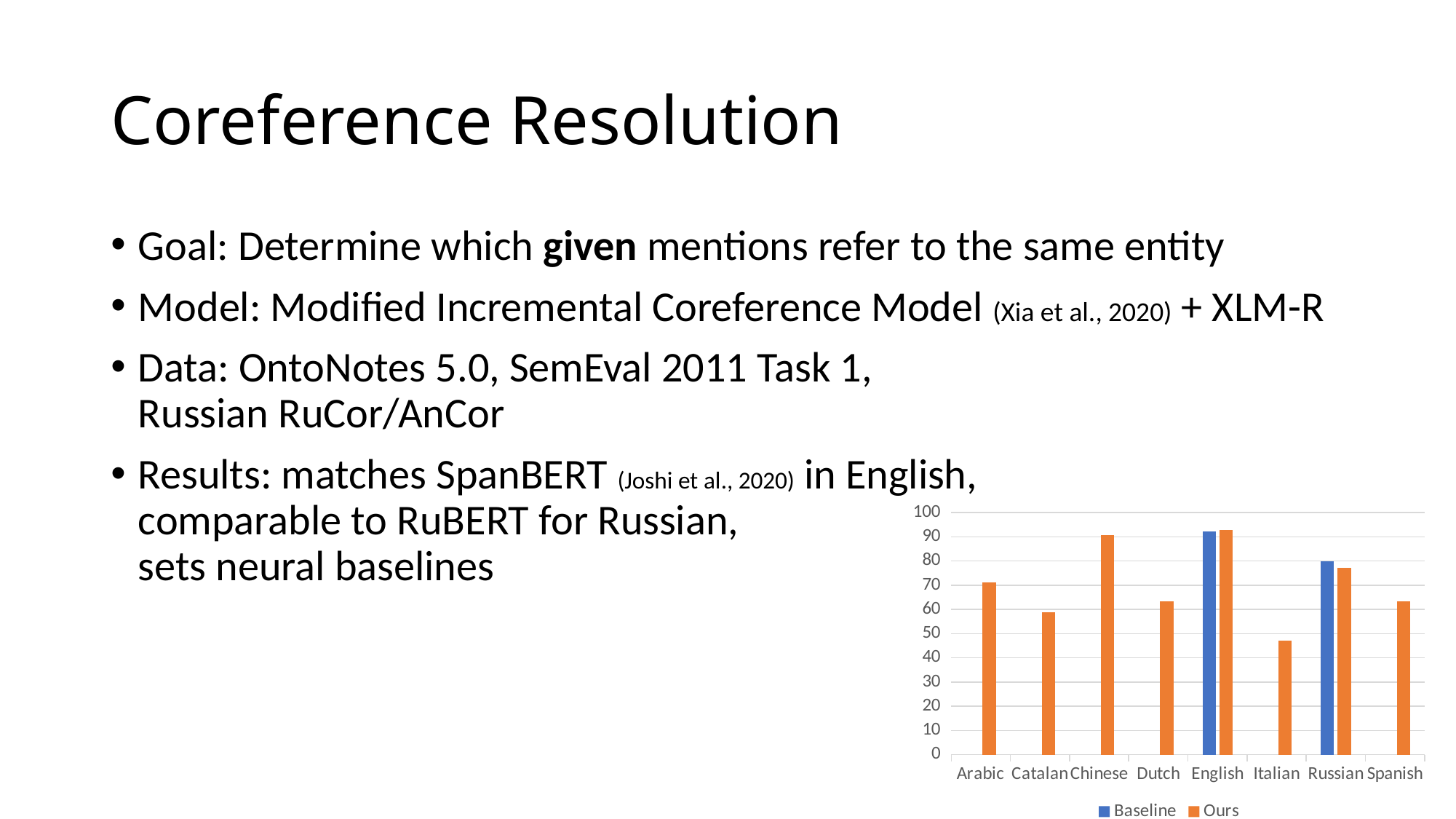
How many series does the chart legend list? 2 Which is larger, the Ours value for Chinese or for Dutch? Chinese What are the two series named in the chart legend? Baseline and Ours Is the Ours value for Arabic greater or less than 60? greater Is the Ours value for Catalan greater or less than 50? greater Which language has the lowest value for the Ours series? Italian How many language categories are shown on the x axis of the chart? 8 Which is larger, the Ours value for Arabic or for Catalan? Arabic What kind of chart is shown on the slide? bar chart Is the Ours value for Italian greater or less than 50? less Which languages have a Baseline bar in the chart? English and Russian